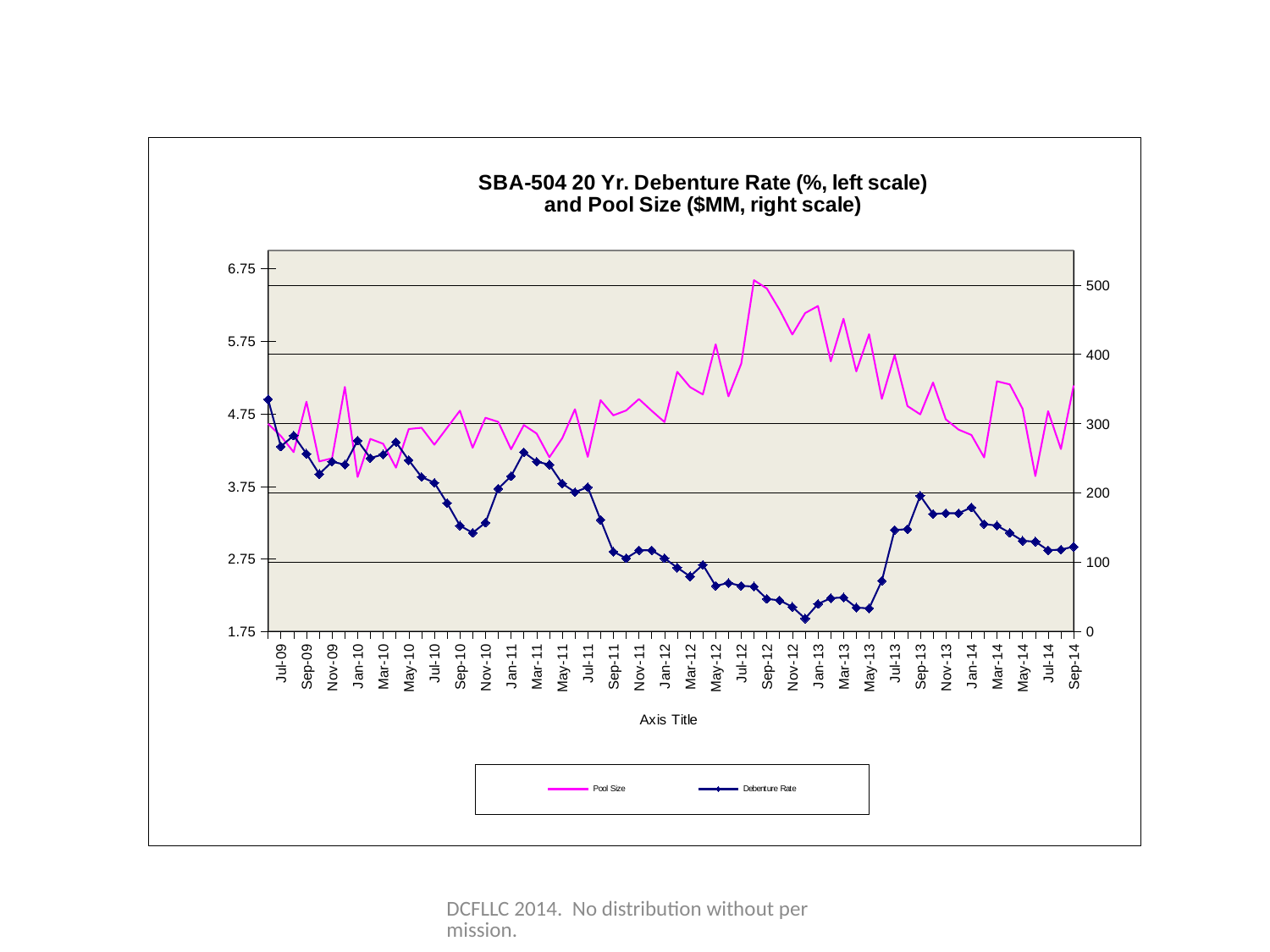
Which is larger, the Debenture Rate at Jul-09 or at Sep-14? Jul-09 What are the two series named in the legend? Pool Size and Debenture Rate Overall, does the Debenture Rate rise or fall from Jul-09 to Sep-14? Fall Is the Pool Size at Sep-14 greater or less than 300 on the right scale? greater Which series is drawn in magenta? Pool Size Is the Pool Size at Aug-12 greater or less than 400 on the right scale? greater Is the Debenture Rate at Dec-12 greater or less than 2.75? less How many series does the legend list? 2 What kind of chart is shown on the slide? Line chart Which series reaches its lowest point around Dec-12? Debenture Rate